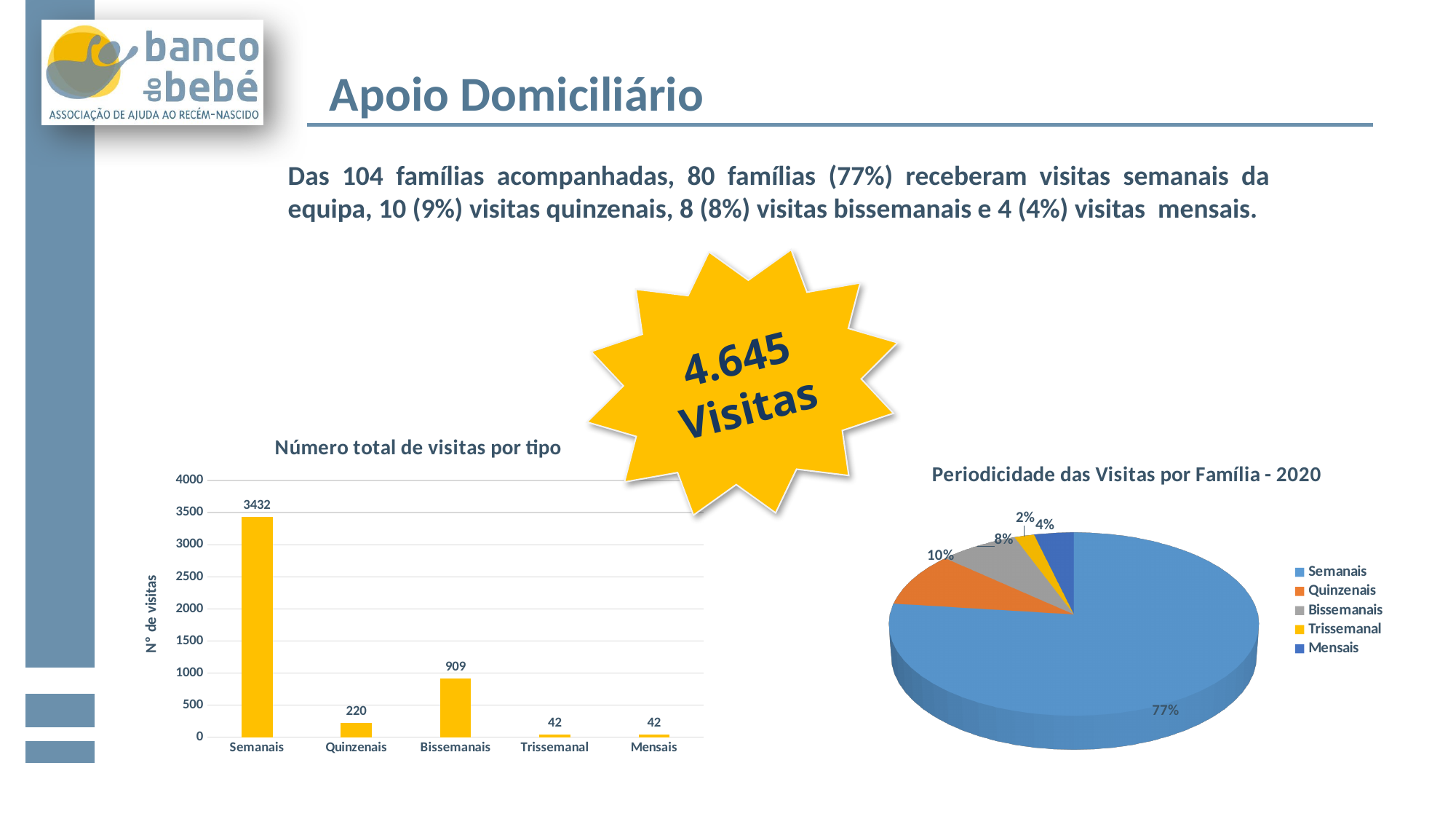
In the chart 'Número total de visitas por tipo', what is the value for Quinzenais? 220 In the chart 'Número total de visitas por tipo', what is the difference between the values for Semanais and Bissemanais? 2523 In the chart 'Número total de visitas por tipo', what is the value for Bissemanais? 909 What kind of chart is 'Número total de visitas por tipo'? Bar chart In the chart 'Periodicidade das Visitas por Família - 2020', which category has the smallest share? Trissemanal In the chart 'Número total de visitas por tipo', which category has the highest value? Semanais In the chart 'Periodicidade das Visitas por Família - 2020', what share does Semanais have? 77% In the chart 'Número total de visitas por tipo', what is the value for Semanais? 3432 In the chart 'Número total de visitas por tipo', which is larger, the value for Quinzenais or the value for Bissemanais? Bissemanais How many entries does the legend of the chart 'Periodicidade das Visitas por Família - 2020' list? 5 How many categories are shown in the chart 'Número total de visitas por tipo'? 5 In the chart 'Periodicidade das Visitas por Família - 2020', what share does Quinzenais have? 10%